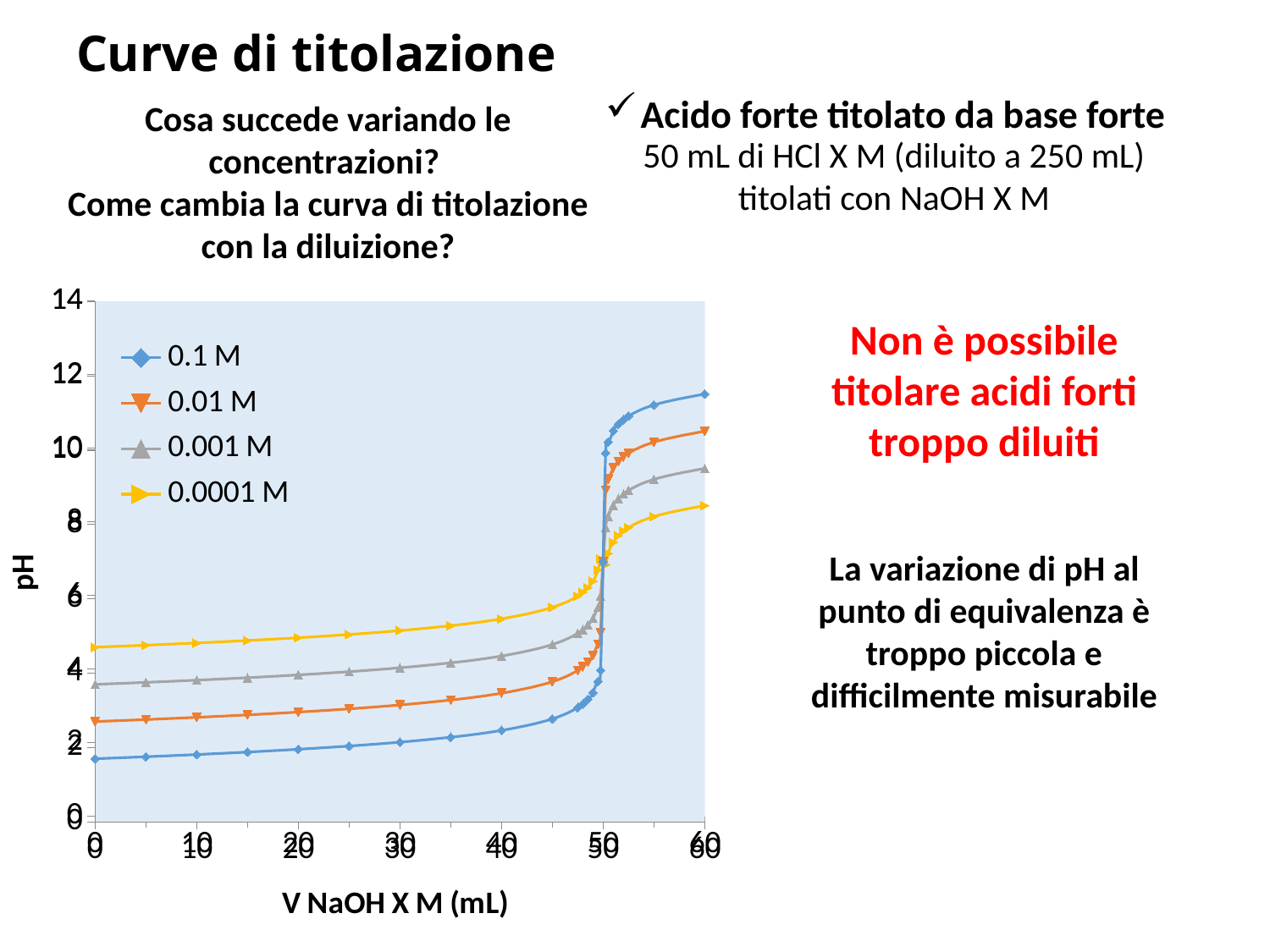
Does the pH of the 0.1 M curve rise or fall as the volume of NaOH increases? rise How many series does the chart legend list? 4 Is the pH of the 0.1 M curve at 0 mL greater or less than 2? less Which series has the highest pH at 60 mL of NaOH? 0.1 M Is the pH of the 0.0001 M curve at 60 mL greater or less than 10? less What are the four series listed in the chart legend? 0.1 M, 0.01 M, 0.001 M, 0.0001 M Is the pH of the 0.1 M curve at 60 mL greater or less than 10? greater What is the label of the chart's x axis? V NaOH X M (mL) At 0 mL of NaOH, which series has the higher pH, 0.01 M or 0.001 M? 0.001 M What kind of chart is shown on the slide? line chart Which series has the lowest pH at 0 mL of NaOH? 0.1 M